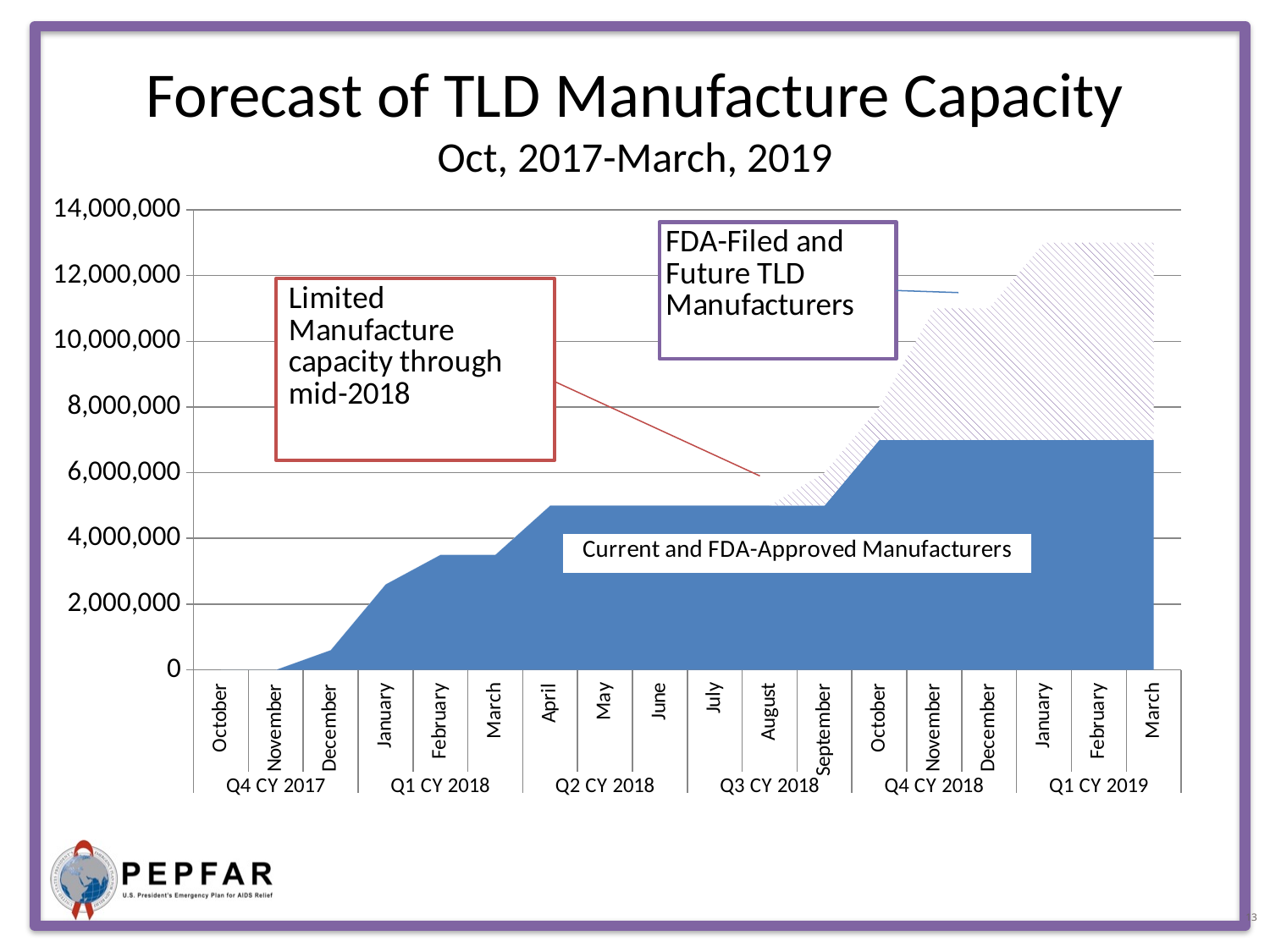
Is the capacity of Current and FDA-Approved Manufacturers in February 2018 greater or less than 4,000,000? less Does the capacity of Current and FDA-Approved Manufacturers rise or fall from October 2017 to March 2019? rise What kind of chart is shown on the slide? area chart Is the capacity of Current and FDA-Approved Manufacturers in May 2018 greater or less than 4,000,000? greater How many months are shown along the x axis? 18 Is the total capacity including FDA-Filed and Future TLD Manufacturers in January 2019 greater or less than 12,000,000? greater What is the title of the chart? Forecast of TLD Manufacture Capacity Which month has the lowest capacity for Current and FDA-Approved Manufacturers? October 2017 and November 2017 How many quarters are labelled along the x axis? 6 What period does the chart subtitle say the forecast covers? Oct, 2017-March, 2019 What is the capacity of Current and FDA-Approved Manufacturers in October 2017? 0